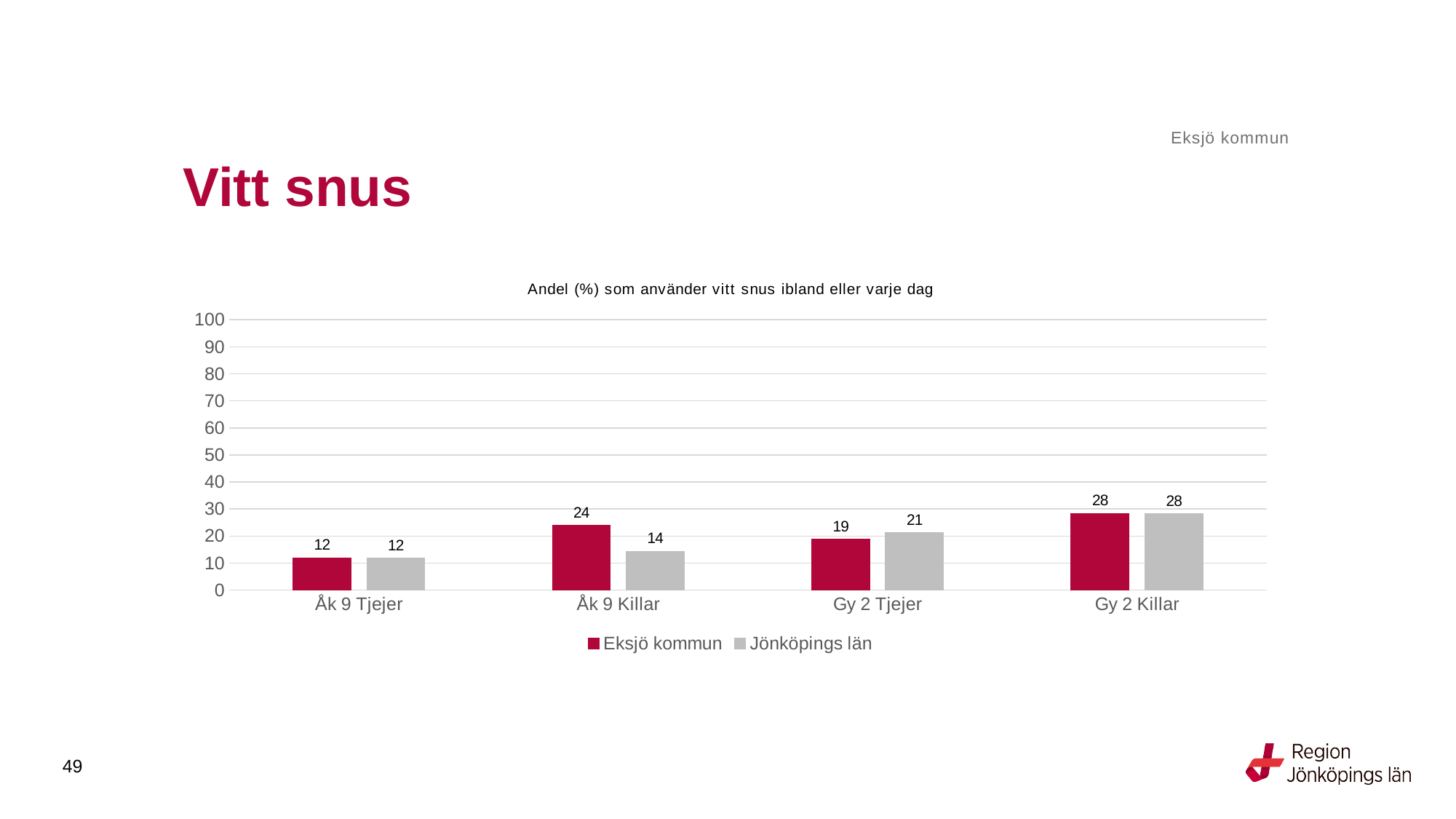
Which is larger in the Gy 2 Tjejer category: Eksjö kommun or Jönköpings län? Jönköpings län Is the value for Eksjö kommun in Gy 2 Killar greater or less than 20? greater What is the difference between Eksjö kommun and Jönköpings län in the Åk 9 Killar category? 10 Which category has the lowest value for Jönköpings län? Åk 9 Tjejer What kind of chart is shown on the slide? Bar chart What is the value for Jönköpings län in the Gy 2 Tjejer category? 21 What is the value for Eksjö kommun in the Åk 9 Killar category? 24 What is the value for Jönköpings län in the Åk 9 Killar category? 14 How many categories are shown on the x axis? 4 What is the title of the chart? Andel (%) som använder vitt snus ibland eller varje dag How many series does the legend list? 2 Which category has the highest value for Eksjö kommun? Gy 2 Killar